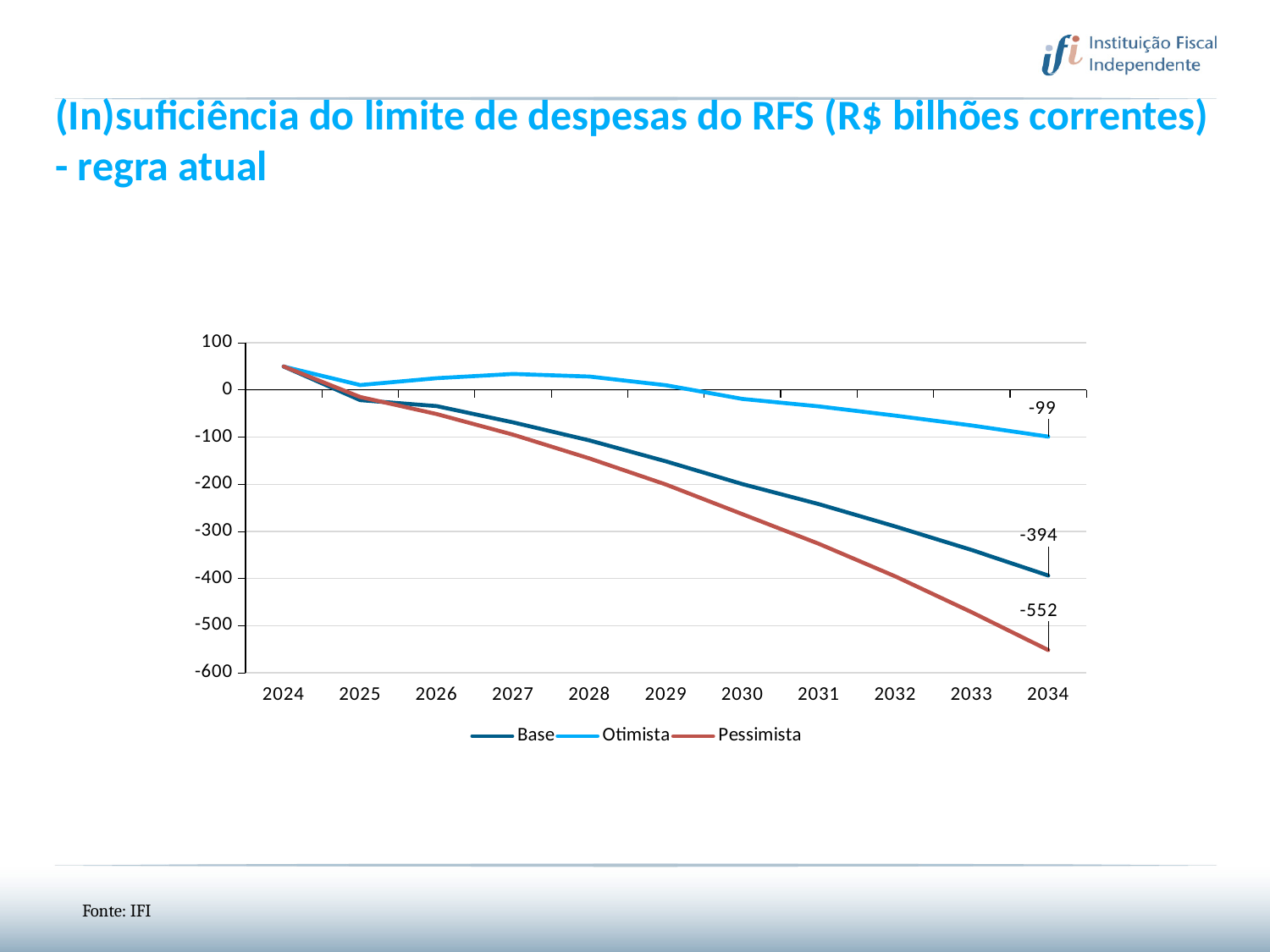
Does the Base series rise or fall from 2024 to 2034? fall Is the value for the Pessimista series in 2030 greater or less than -200? less What is the value of the Base series in 2034? -394 What is the difference between the Base and Pessimista values in 2034? 158 Which series has the highest value in 2034? Otimista What is the difference between the Otimista and Base values in 2034? 295 What is the value of the Pessimista series in 2034? -552 Which series has the lowest value in 2034? Pessimista What is the value of the Otimista series in 2034? -99 Is the value for the Otimista series in 2027 greater or less than 0? greater How many years are shown on the x axis? 11 How many series does the legend list? 3